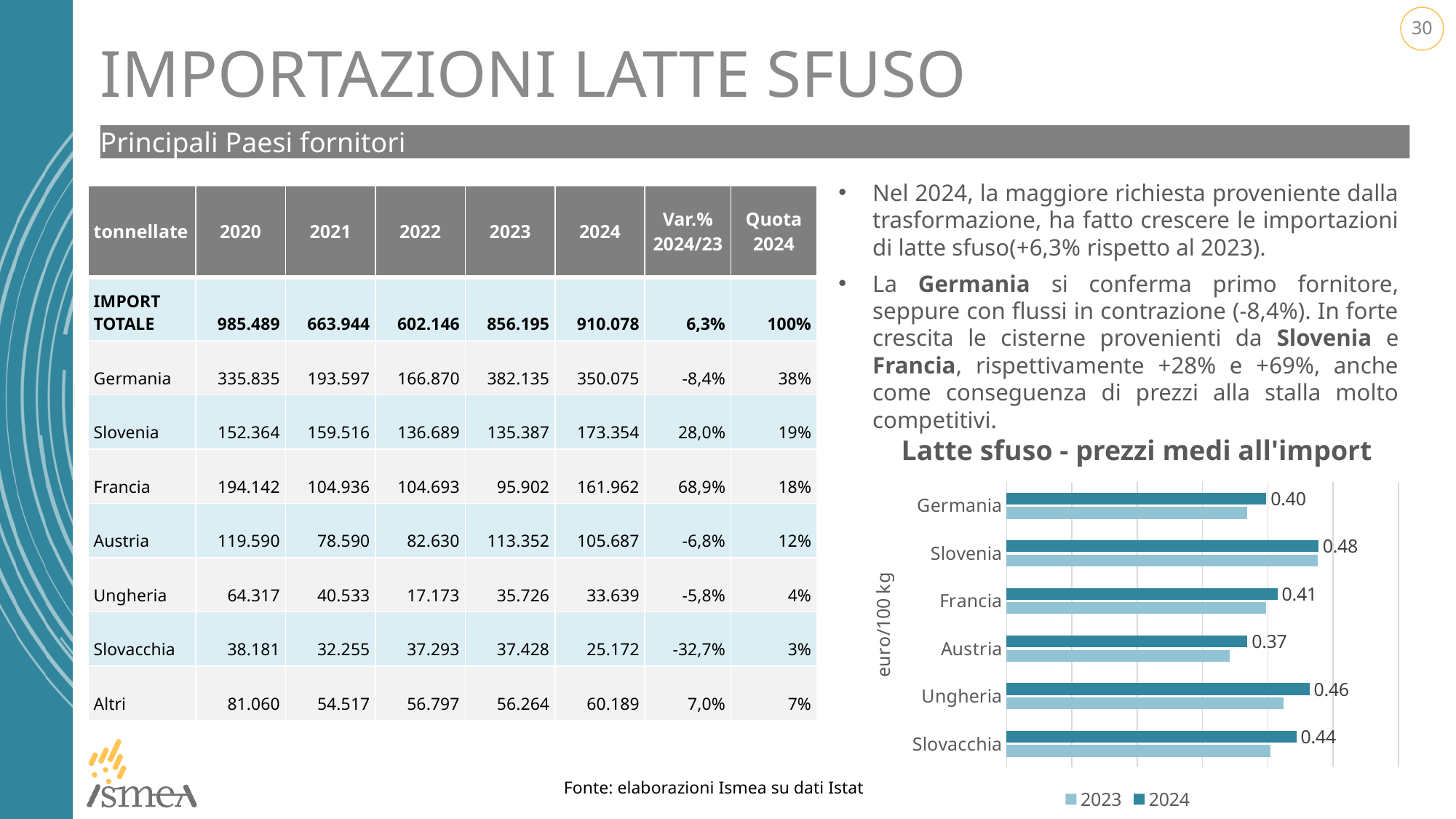
What kind of chart is 'Latte sfuso - prezzi medi all'import'? Bar chart In the chart 'Latte sfuso - prezzi medi all'import', what is the 2024 value for Austria? 0.37 How many series does the legend of the chart 'Latte sfuso - prezzi medi all'import' list? 2 In the chart 'Latte sfuso - prezzi medi all'import', which is larger for 2024: Francia or Slovacchia? Slovacchia In the chart 'Latte sfuso - prezzi medi all'import', which country has the lowest 2024 value? Austria In the chart 'Latte sfuso - prezzi medi all'import', what is the difference between the 2024 values for Slovenia and Austria? 0.11 In the chart 'Latte sfuso - prezzi medi all'import', what is the 2024 value for Germania? 0.40 In the chart 'Latte sfuso - prezzi medi all'import', for Germania, which year's bar is longer: 2023 or 2024? 2024 How many countries are shown in the chart 'Latte sfuso - prezzi medi all'import'? 6 In the chart 'Latte sfuso - prezzi medi all'import', which country has the highest 2024 value? Slovenia In the chart 'Latte sfuso - prezzi medi all'import', what is the 2024 value for Slovenia? 0.48 In the chart 'Latte sfuso - prezzi medi all'import', what is the 2024 value for Ungheria? 0.46